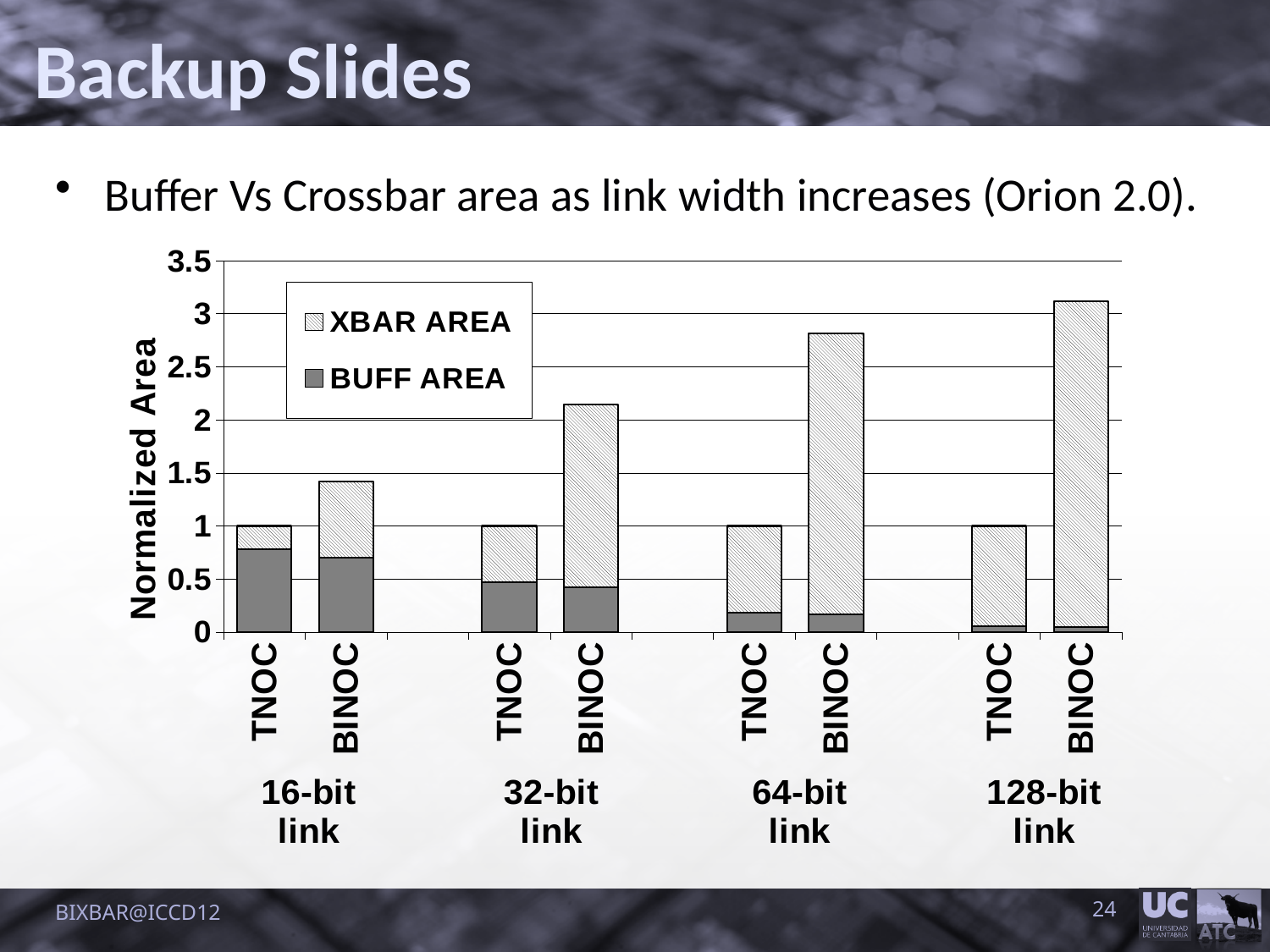
How does the total normalized area of the BINOC bars change as the link width increases from 16-bit to 128-bit? It rises Is the total normalized area for BINOC at the 64-bit link greater or less than 2.5? greater What is the label of the vertical axis? Normalized Area How many series does the legend list? 2 Which is larger, the total normalized area for BINOC at the 32-bit link or for BINOC at the 16-bit link? BINOC at the 32-bit link What are the two series named in the legend? XBAR AREA and BUFF AREA Is the BUFF AREA value for TNOC at the 16-bit link greater or less than 0.5? greater Which bar has the highest total normalized area? BINOC at 128-bit link What is the total normalized area of the TNOC bar for the 16-bit link? 1 What kind of chart is shown on the slide? Stacked bar chart Is the total normalized area for BINOC at the 128-bit link greater or less than 3? greater How many bars are plotted in the chart? 8